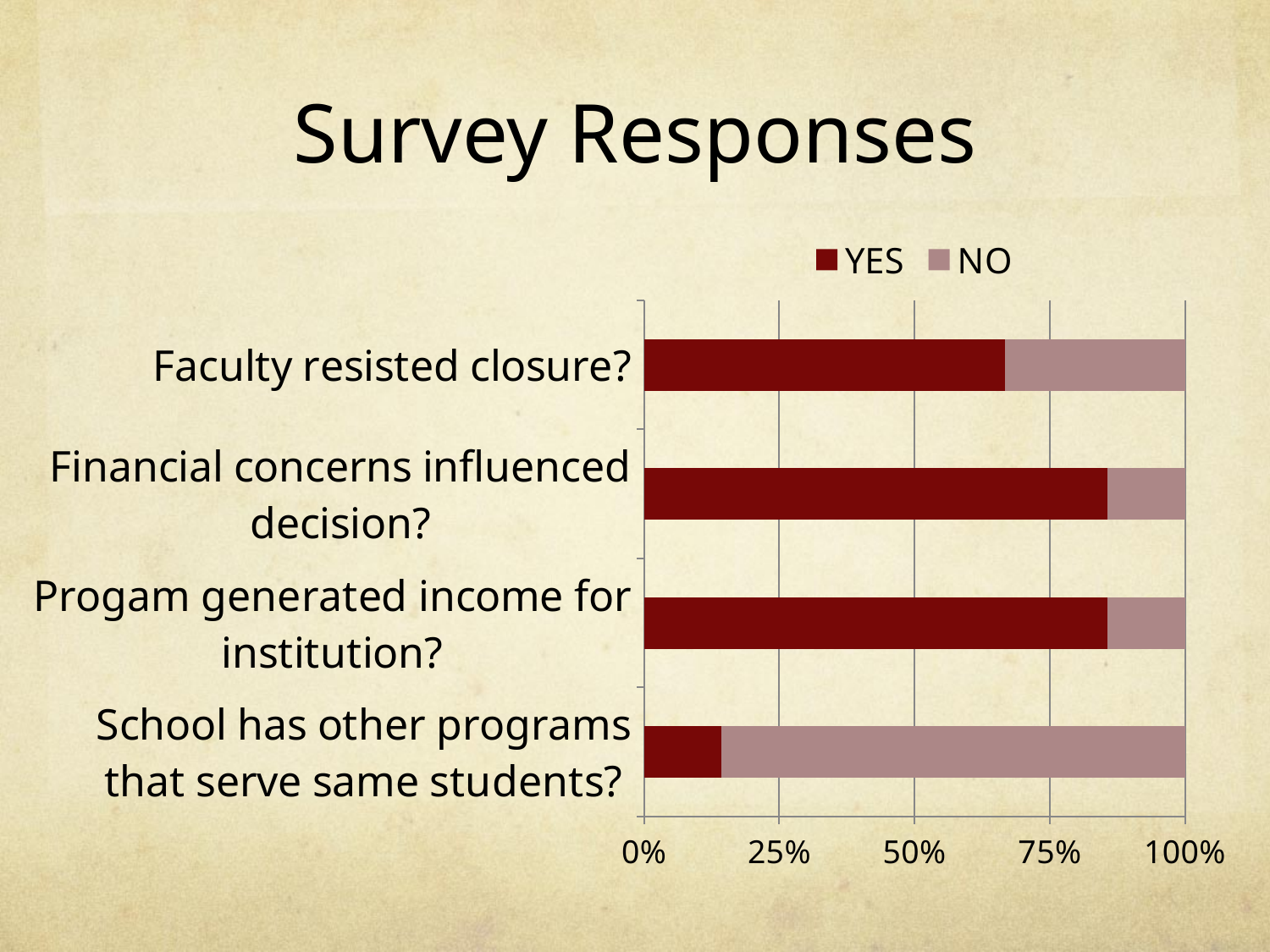
What is the title of the slide containing the chart? Survey Responses Which is larger: the NO share for "Faculty resisted closure?" or the NO share for "Financial concerns influenced decision?" Faculty resisted closure? What are the two entries in the chart's legend? YES and NO Is the YES share for "Financial concerns influenced decision?" greater or less than 75%? greater Which category has the lowest YES share? School has other programs that serve same students? How many series does the legend list? 2 What kind of chart is shown on the slide? Bar chart Which category has the highest NO share? School has other programs that serve same students? How many survey questions (categories) are plotted on the chart? 4 Is the YES share for "School has other programs that serve same students?" greater or less than 25%? less Which is larger: the YES share for "Faculty resisted closure?" or the YES share for "Progam generated income for institution?" Progam generated income for institution? Is the YES share for "Faculty resisted closure?" greater or less than 50%? greater